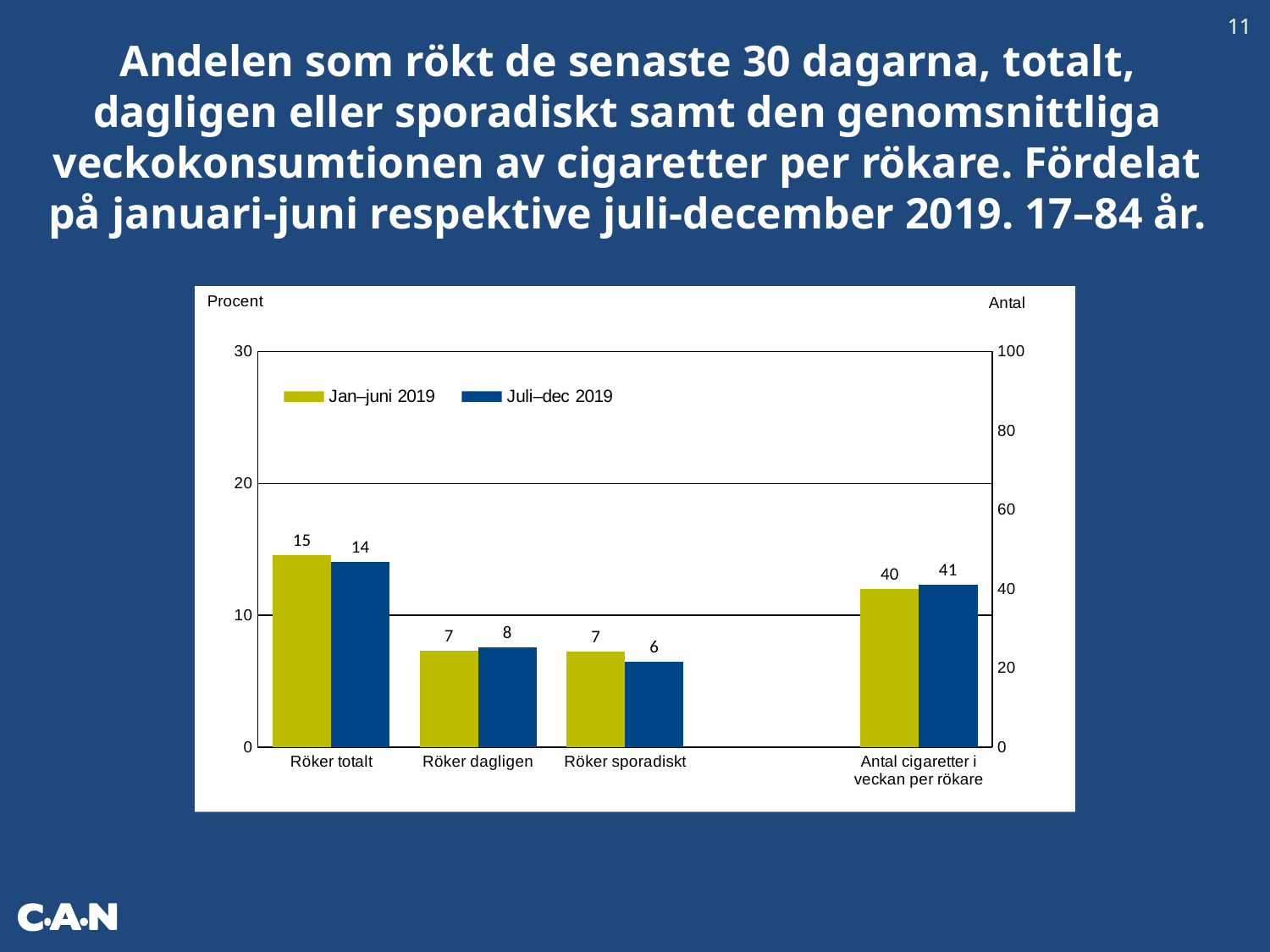
How many series does the legend list? 2 What is the value for Röker totalt in the Jan–juni 2019 series? 15 Which category has the highest value in the Juli–dec 2019 series? Antal cigaretter i veckan per rökare What is the value for Antal cigaretter i veckan per rökare in the Jan–juni 2019 series? 40 What kind of chart is shown on the slide? Bar chart What is the difference between the Jan–juni 2019 and Juli–dec 2019 values for Röker totalt? 1 What is the value for Röker sporadiskt in the Juli–dec 2019 series? 6 For Röker sporadiskt, which series has the larger value, Jan–juni 2019 or Juli–dec 2019? Jan–juni 2019 What is the label of the right-hand vertical axis? Antal What is the value for Röker dagligen in the Juli–dec 2019 series? 8 Which category has the lowest value in the Juli–dec 2019 series? Röker sporadiskt How many categories are shown on the x axis? 4